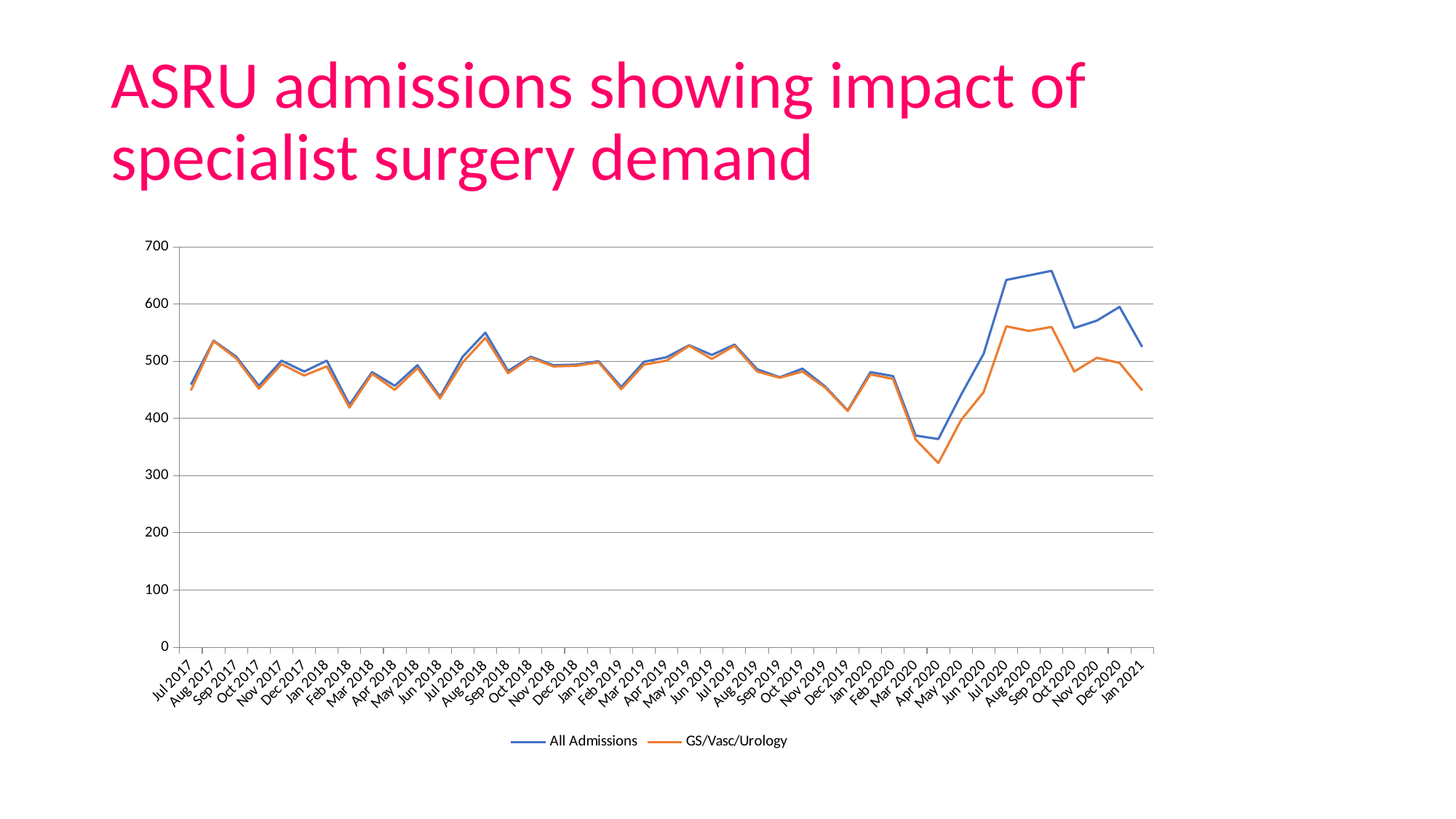
Is the GS/Vasc/Urology value for Jan 2021 greater or less than 500? less In which month does the GS/Vasc/Urology series reach its lowest value? Apr 2020 Is the All Admissions value for Sep 2020 greater or less than 600? greater What kind of chart is shown on the slide? line chart Between Apr 2020 and Sep 2020, does the All Admissions series rise or fall? rise In which month does the All Admissions series reach its highest value? Sep 2020 Is the GS/Vasc/Urology value for Apr 2020 greater or less than 400? less How many months are plotted along the x axis? 43 In Sep 2020, which series has the larger value, All Admissions or GS/Vasc/Urology? All Admissions How many series does the legend list? 2 What colour is the All Admissions line? blue